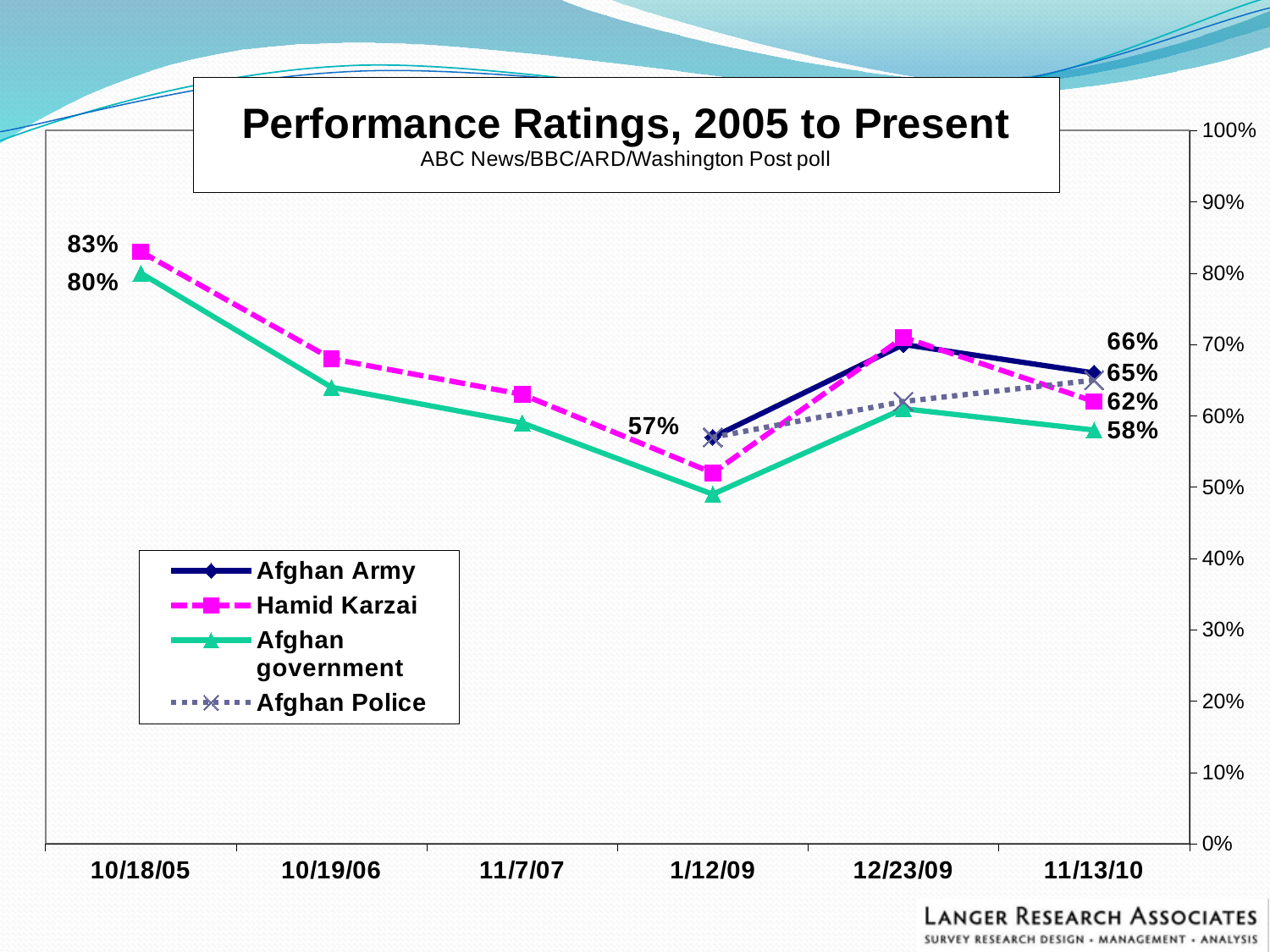
Which series has the highest value at 11/13/10? Afghan Army Is the value for Hamid Karzai at 10/19/06 greater or less than 60%? greater What is the difference between Hamid Karzai's rating at 10/18/05 and at 11/13/10? 21 percentage points What kind of chart is shown on the slide? Line chart What is the value labeled for Afghan Army at 11/13/10? 66% Which series has the lowest value at 11/13/10? Afghan government How many dates are shown on the x axis? 6 What is the value labeled for Afghan Police at 11/13/10? 65% What is the value labeled for Afghan government at 10/18/05? 80% What is the value labeled for Hamid Karzai at 10/18/05? 83% How many series does the legend list? 4 What is the value labeled for Afghan government at 11/13/10? 58%